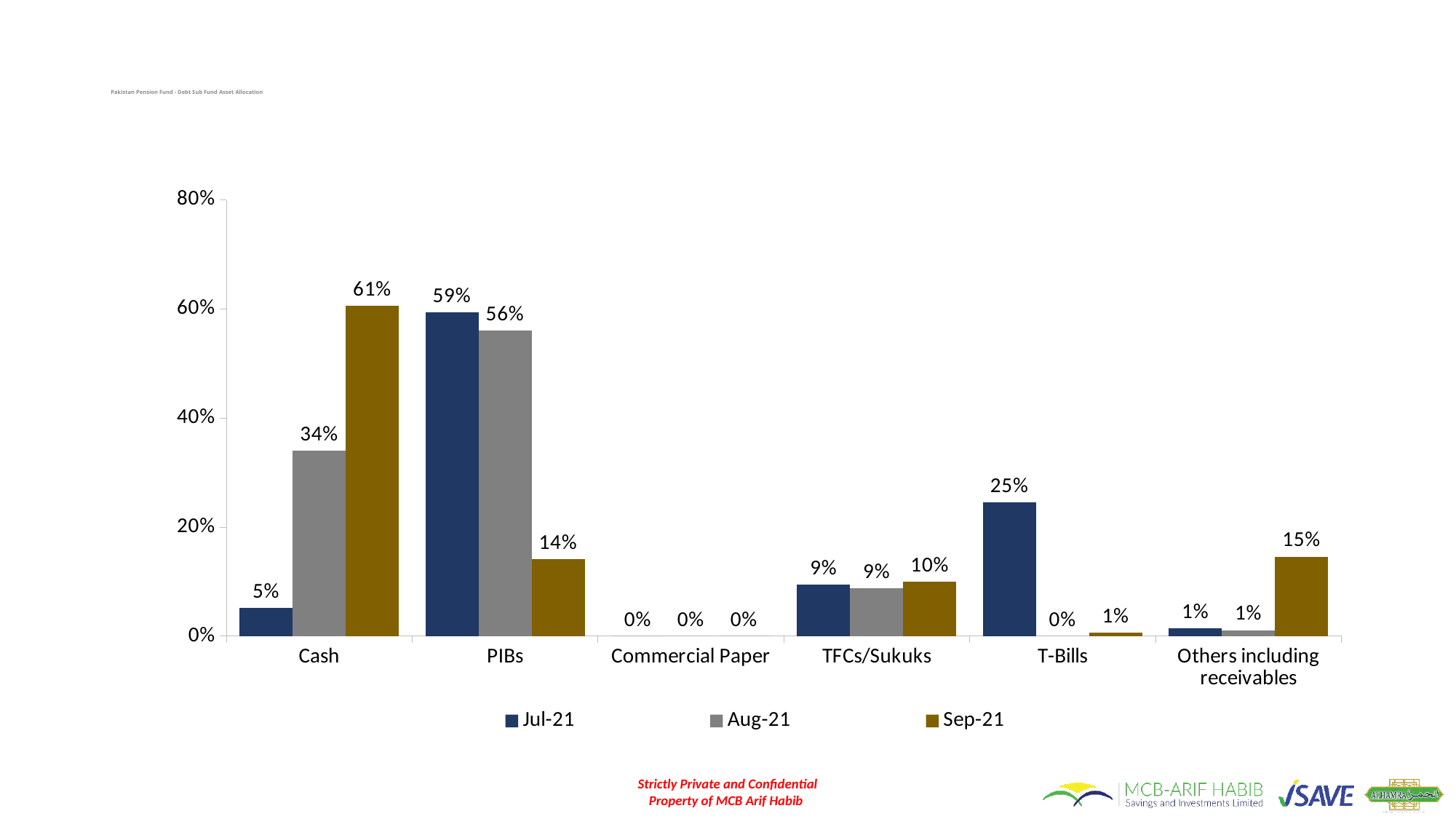
Which is larger, the Aug-21 value for PIBs or the Aug-21 value for Cash? Aug-21 value for PIBs How many series does the legend list? 3 What is the Sep-21 value for Cash? 61% How many categories are shown on the x axis? 6 What is the difference between the Sep-21 and Jul-21 values for Cash? 56% What is the Aug-21 value for T-Bills? 0% Which category has the highest Jul-21 value? PIBs What is the Jul-21 value for PIBs? 59% Which category has the highest Sep-21 value? Cash What is the Sep-21 value for Others including receivables? 15% What kind of chart is shown on the slide? Bar chart Which series is shown in grey in the legend? Aug-21